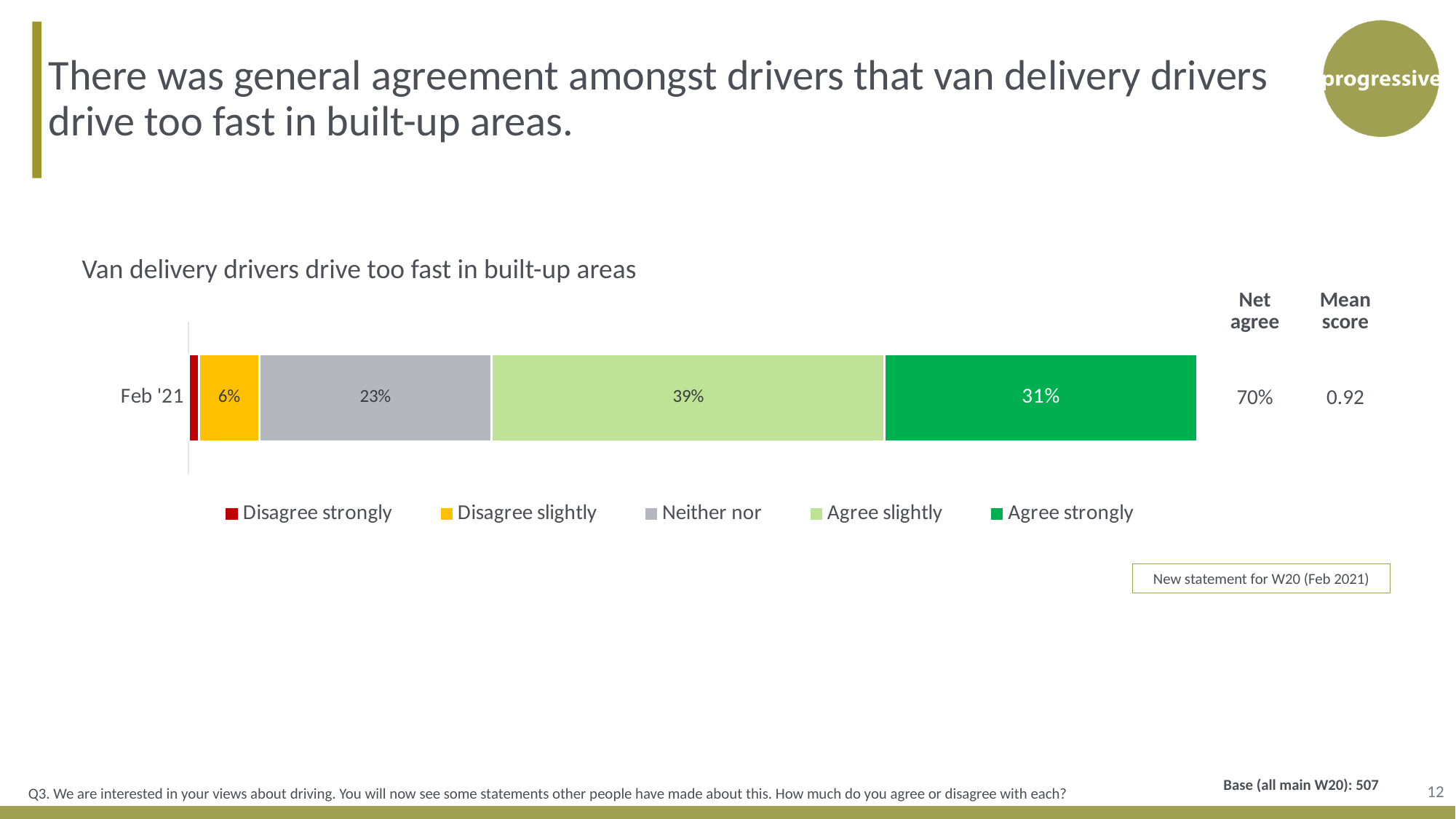
What percentage is shown for 'Neither nor'? 23% How many time periods (categories) are plotted on the chart? 1 How many series does the legend list? 5 Which response category has the largest share of the Feb '21 bar? Agree slightly What is the value for 'Disagree slightly'? 6% What percentage of drivers agreed slightly that van delivery drivers drive too fast in built-up areas? 39% What is the value for 'Agree strongly' in the Feb '21 bar? 31% Which is larger, the share for 'Agree strongly' or the share for 'Neither nor'? Agree strongly What is the net agree figure shown next to the chart? 70% What is the difference between the 'Agree slightly' and 'Agree strongly' percentages? 8 percentage points Which response category has the smallest share of the Feb '21 bar? Disagree strongly What kind of chart is shown on the slide? Stacked bar chart